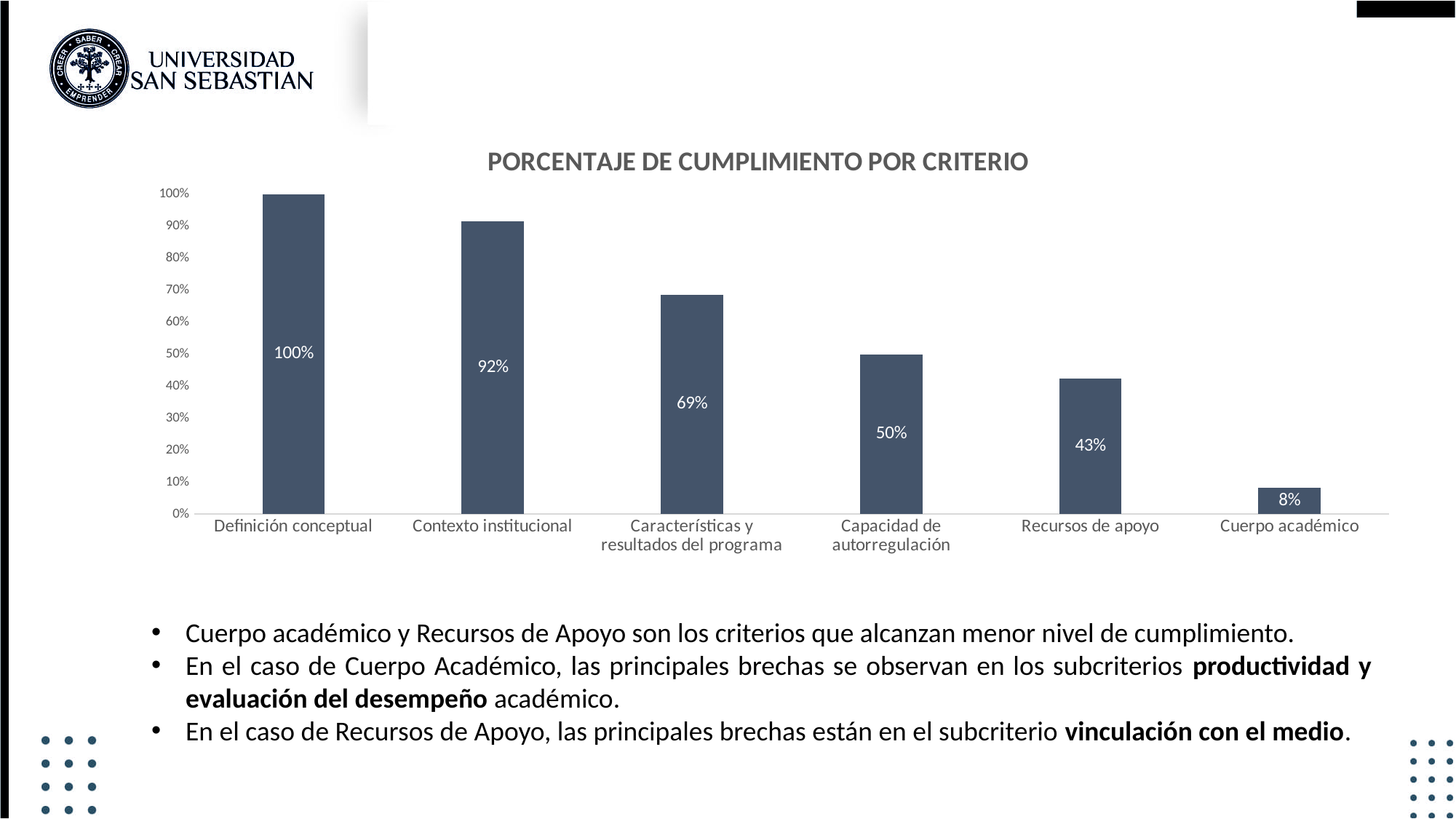
What kind of chart is shown on the slide? Bar chart What is the difference between the values for Capacidad de autorregulación and Cuerpo académico? 42% What is the value for Características y resultados del programa? 69% Which is larger, the value for Contexto institucional or the value for Características y resultados del programa? Contexto institucional What is the value for Definición conceptual? 100% What is the value for Contexto institucional? 92% What is the value for Recursos de apoyo? 43% How many categories are shown on the x axis? 6 Which category has the highest value? Definición conceptual Which category has the lowest value? Cuerpo académico Do the values rise or fall from left to right along the x axis? Fall What is the title of the chart? PORCENTAJE DE CUMPLIMIENTO POR CRITERIO